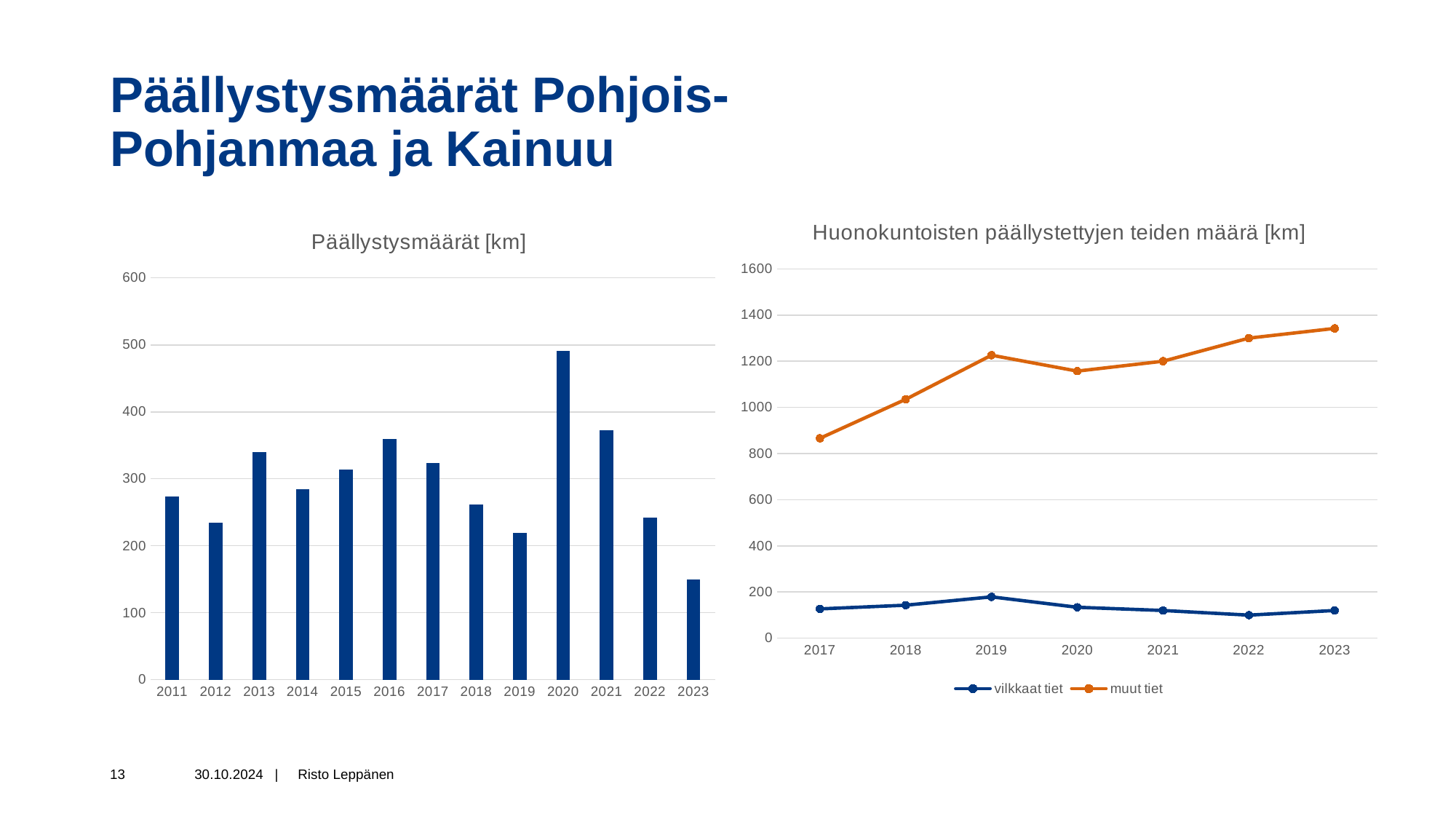
In the left chart "Päällystysmäärät [km]", which year has the highest value? 2020 In the left chart "Päällystysmäärät [km]", how many years are shown on the x axis? 13 In the right chart "Huonokuntoisten päällystettyjen teiden määrä [km]", does the muut tiet series overall rise or fall from 2017 to 2023? rise In the right chart "Huonokuntoisten päällystettyjen teiden määrä [km]", how many series does the legend list? 2 In the left chart "Päällystysmäärät [km]", is the value for 2020 greater or less than 400? greater In the right chart "Huonokuntoisten päällystettyjen teiden määrä [km]", is the value for muut tiet in 2023 greater or less than 1200? greater In the left chart "Päällystysmäärät [km]", which year has the larger value, 2012 or 2013? 2013 In the right chart "Huonokuntoisten päällystettyjen teiden määrä [km]", which year has the lowest value for muut tiet? 2017 In the left chart "Päällystysmäärät [km]", is the value for 2023 greater or less than 200? less What kind of chart is the left chart titled "Päällystysmäärät [km]"? bar chart In the left chart "Päällystysmäärät [km]", which year has the lowest value? 2023 What kind of chart is the right chart titled "Huonokuntoisten päällystettyjen teiden määrä [km]"? line chart